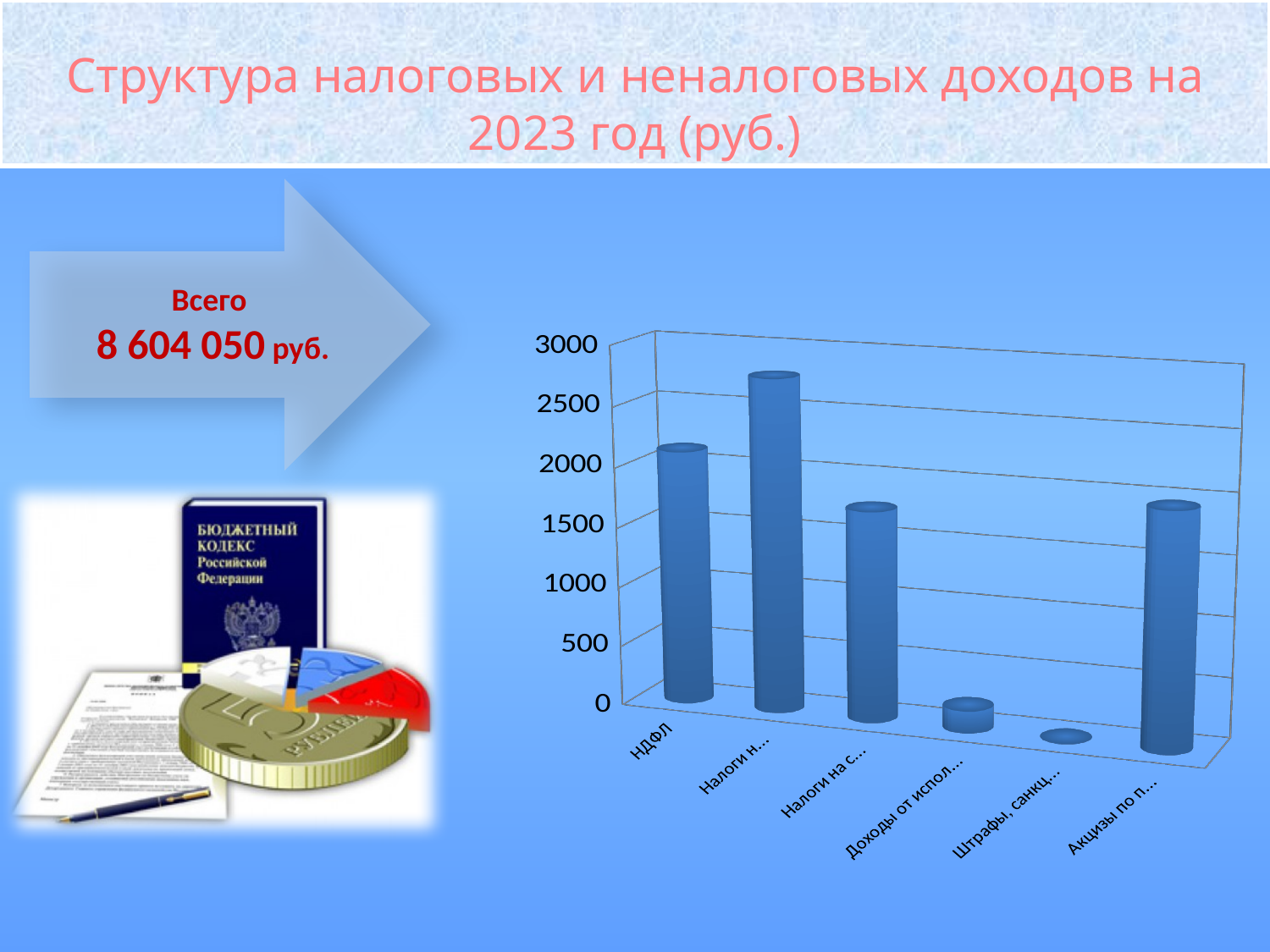
Which category has the highest value in the chart? Налоги н... Which is larger, the value for НДФЛ or the value for Налоги н...? Налоги н... Is the value for Налоги н... greater or less than 2500? greater What is the highest value shown on the vertical axis of the chart? 3000 Which is larger, the value for НДФЛ or the value for Доходы от испол...? НДФЛ Is the value for Налоги на с... greater or less than 1000? greater Which is larger, the value for Доходы от испол... or the value for Штрафы, санкц...? Доходы от испол... Which category has the lowest value in the chart? Штрафы, санкц... What kind of chart is shown on the slide? bar chart Is the value for Доходы от испол... greater or less than 500? less How many categories are plotted in the chart? 6